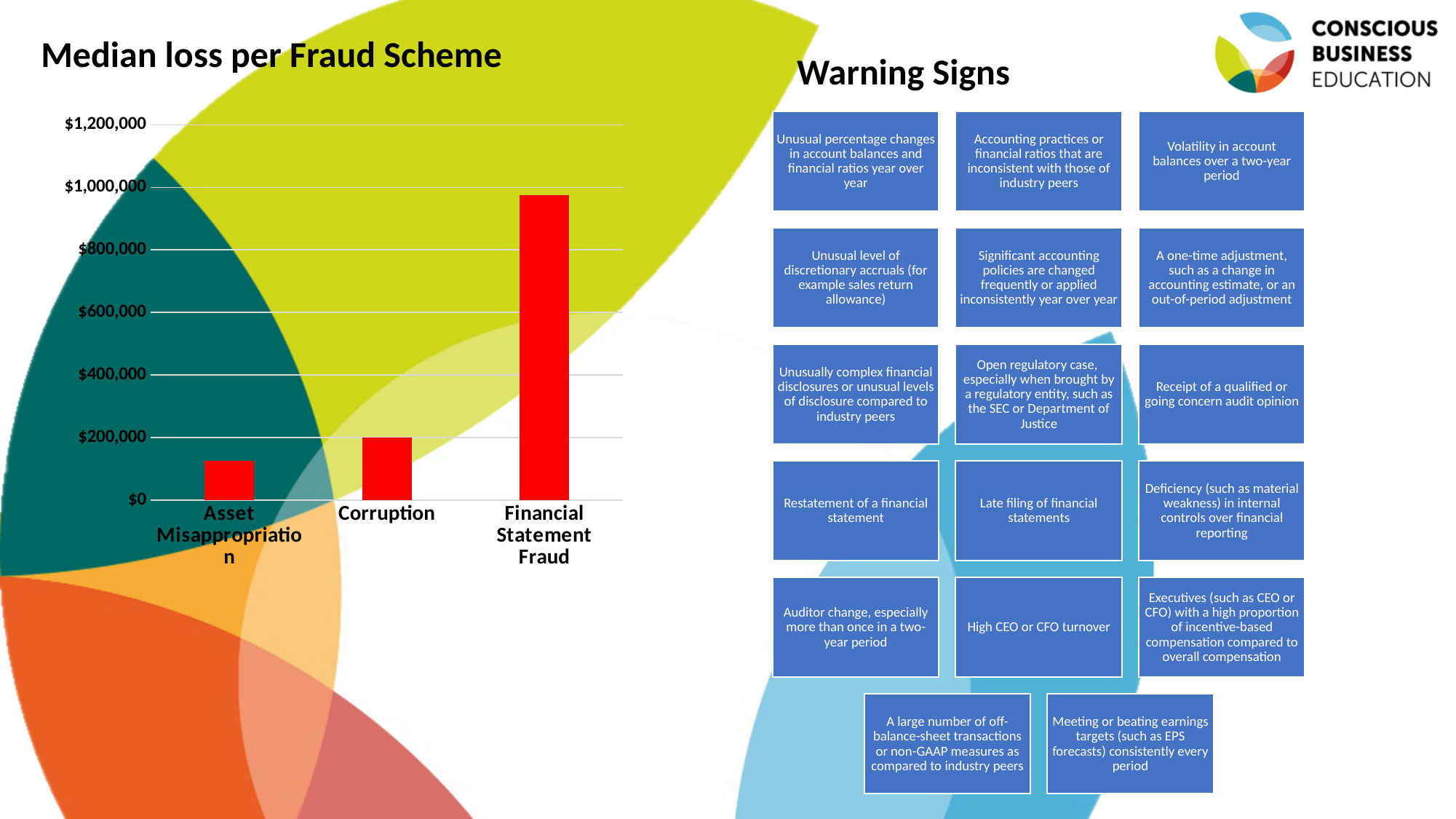
Is the median loss for Financial Statement Fraud greater or less than $800,000? greater Which has a larger median loss, Corruption or Asset Misappropriation? Corruption Which fraud scheme has the lowest median loss in the chart? Asset Misappropriation What kind of chart is shown under the title "Median loss per Fraud Scheme"? bar chart What is the title of the chart on the left of the slide? Median loss per Fraud Scheme Is the median loss for Asset Misappropriation greater or less than $200,000? less Is the median loss for Financial Statement Fraud greater or less than $1,000,000? less Which fraud scheme has the highest median loss in the chart? Financial Statement Fraud Do the bar values rise or fall from left to right across the categories in the chart? rise How many fraud scheme categories are plotted in the "Median loss per Fraud Scheme" chart? 3 What is the highest value labelled on the vertical axis of the chart? $1,200,000